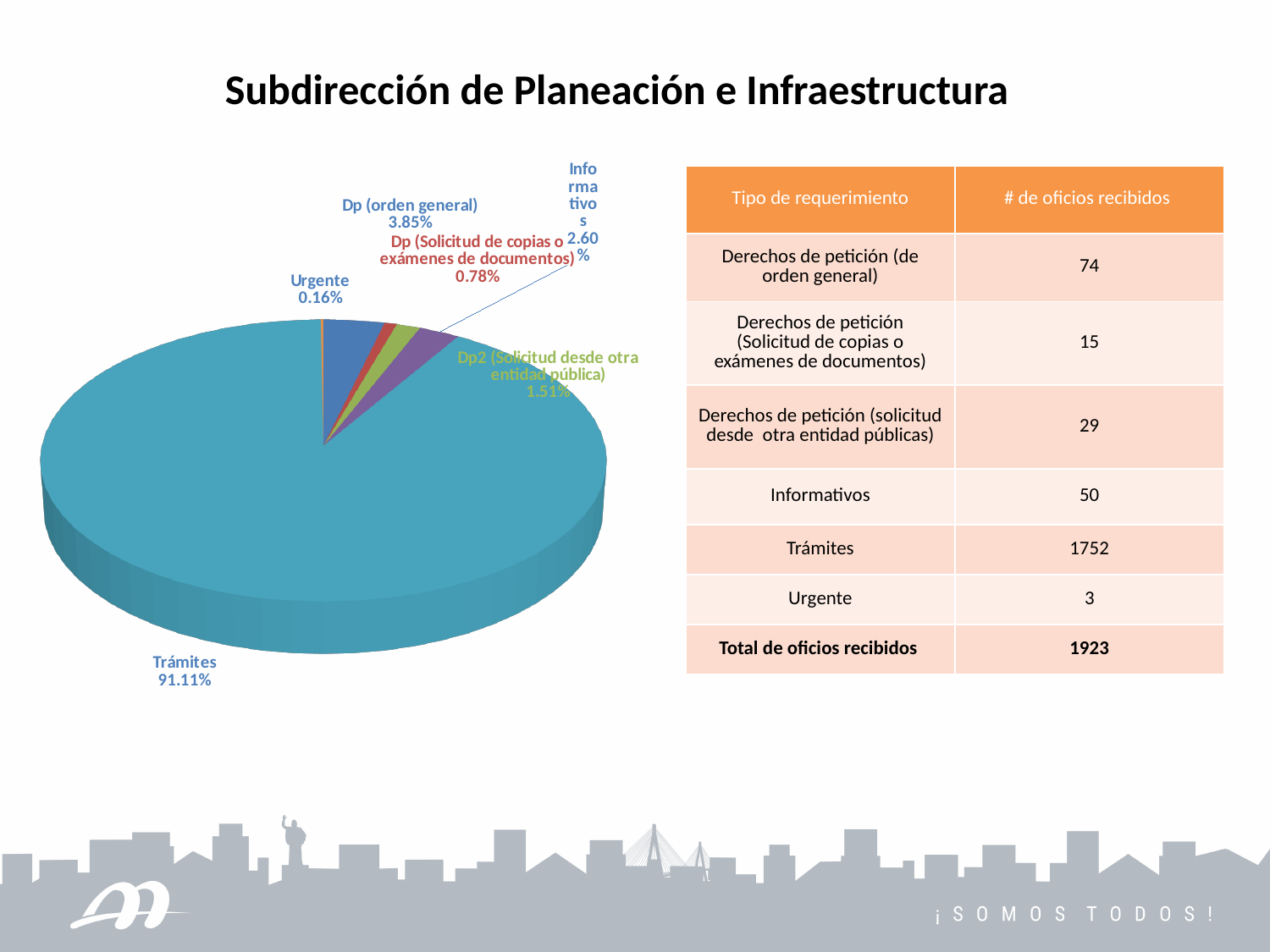
What percentage is shown for Dp (Solicitud de copias o exámenes de documentos) in the pie chart? 0.78% What percentage share does the Trámites slice have in the pie chart? 91.11% Which is larger in the pie chart, Dp (orden general) or Informativos? Dp (orden general) Which slice of the pie chart is the smallest? Urgente What percentage is shown for Dp (orden general) in the pie chart? 3.85% How many slices does the pie chart have? 6 What percentage is shown for Urgente in the pie chart? 0.16% What percentage is shown for Informativos in the pie chart? 2.60% What percentage is shown for Dp2 (Solicitud desde otra entidad pública) in the pie chart? 1.51% Which slice of the pie chart is the largest? Trámites What kind of chart is shown on the slide? pie chart What is the difference in percentage points between Dp (orden general) and Informativos in the pie chart? 1.25